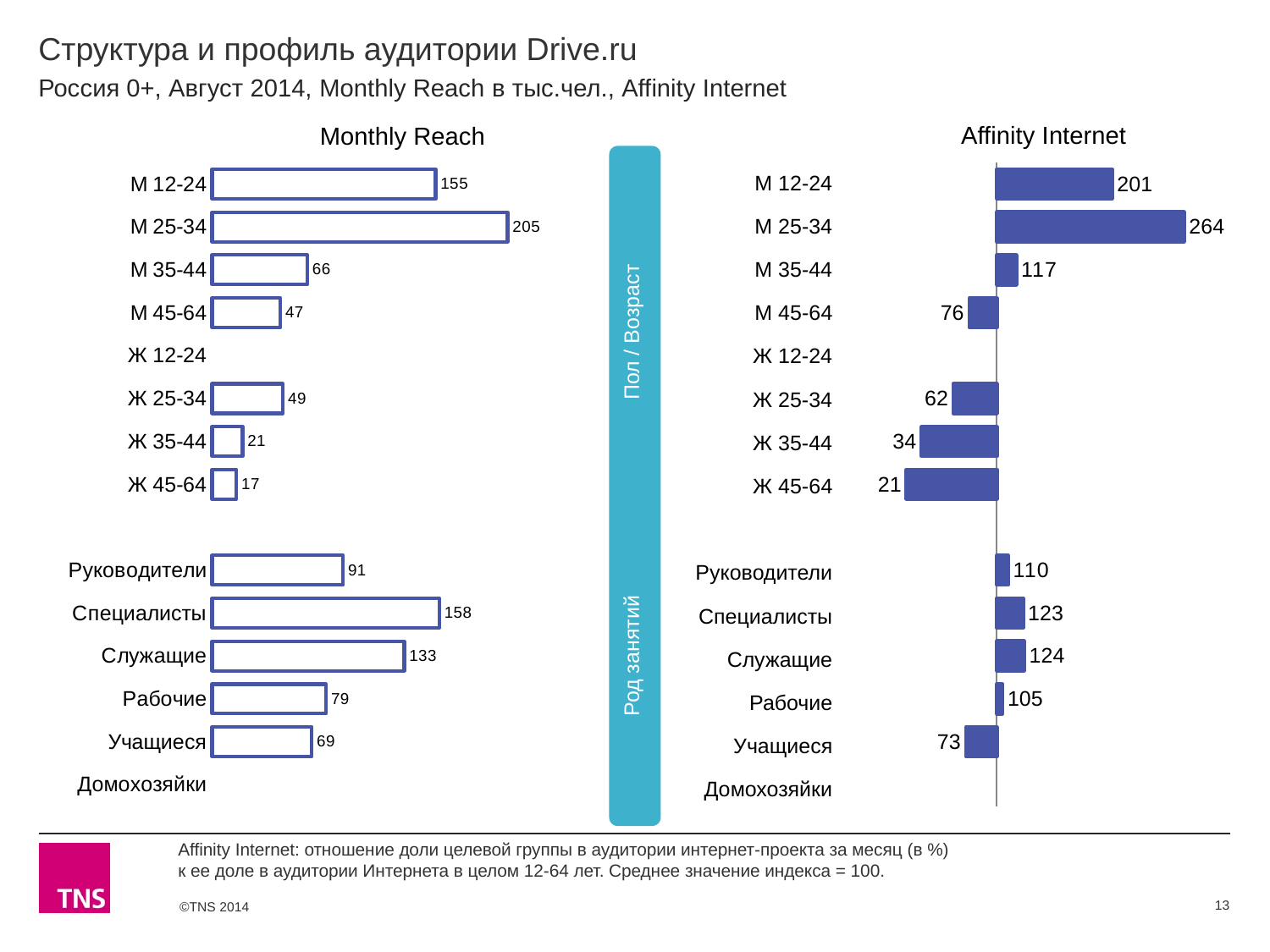
On the Monthly Reach chart, what is the value for М 25-34? 205 On the Monthly Reach chart, which category has the lowest labelled value? Ж 45-64 On the Affinity Internet chart, what is the value for Учащиеся? 73 On the Monthly Reach chart, which category has the highest value? М 25-34 On the Affinity Internet chart, what is the value for М 35-44? 117 On the Affinity Internet chart, do the values rise or fall going from М 12-24 down to М 45-64? Rise then fall What type of chart is the Monthly Reach chart? Bar chart On the Affinity Internet chart, which category has the highest value? М 25-34 On the Monthly Reach chart, what is the value for Служащие? 133 On the Affinity Internet chart, which is larger: the value for Руководители or the value for Рабочие? Руководители On the Monthly Reach chart, what is the difference between the values for Специалисты and Рабочие? 79 On the Affinity Internet chart, what is the difference between the values for М 12-24 and М 45-64? 125